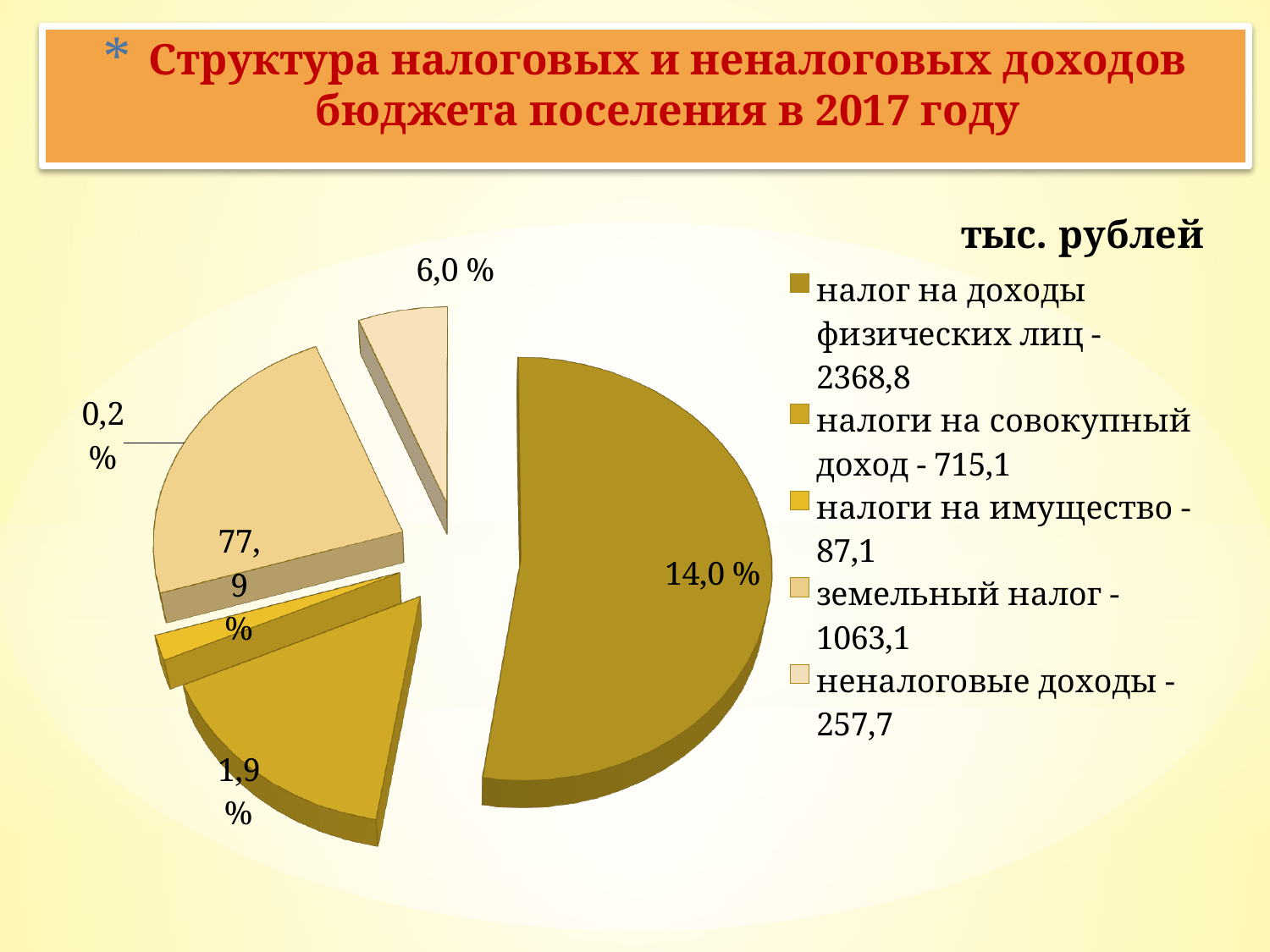
How many categories does the legend of the pie chart list? 5 Which is larger according to the legend: земельный налог or налоги на совокупный доход? земельный налог What value is given in the legend for налог на доходы физических лиц? 2368,8 Which category has the highest value according to the legend? налог на доходы физических лиц What value is given in the legend for неналоговые доходы? 257,7 What value is given in the legend for налоги на имущество? 87,1 In what units are the values in the legend given, as stated above the legend? тыс. рублей Which category has the lowest value according to the legend? налоги на имущество What is the difference between the legend values for налог на доходы физических лиц and земельный налог? 1305,7 What kind of chart is shown on the slide? pie chart What value is given in the legend for земельный налог? 1063,1 What value is given in the legend for налоги на совокупный доход? 715,1